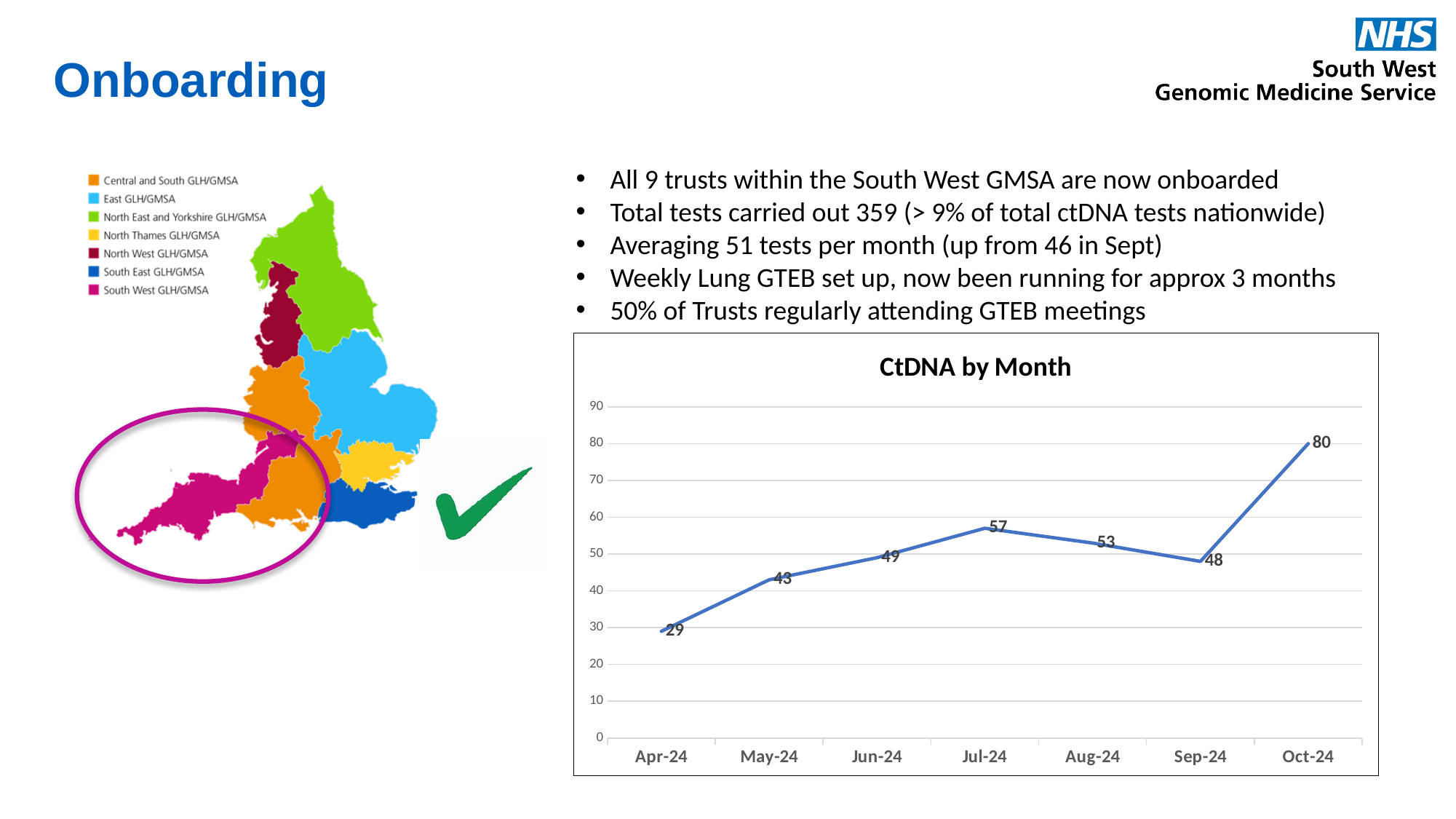
What is the value for Apr-24 in the CtDNA by Month chart? 29 In the CtDNA by Month chart, do the values rise or fall from Apr-24 to Jul-24? rise Which month has the highest value in the CtDNA by Month chart? Oct-24 How many months are plotted in the CtDNA by Month chart? 7 What is the value for Sep-24 in the CtDNA by Month chart? 48 What is the title of the chart on the slide? CtDNA by Month Which month has the lowest value in the CtDNA by Month chart? Apr-24 What is the difference between the Jul-24 and Aug-24 values in the CtDNA by Month chart? 4 What is the difference between the Oct-24 and Sep-24 values in the CtDNA by Month chart? 32 What is the value for Jul-24 in the CtDNA by Month chart? 57 Which is larger in the CtDNA by Month chart, the value for Jun-24 or the value for Aug-24? Aug-24 What kind of chart is CtDNA by Month? line chart